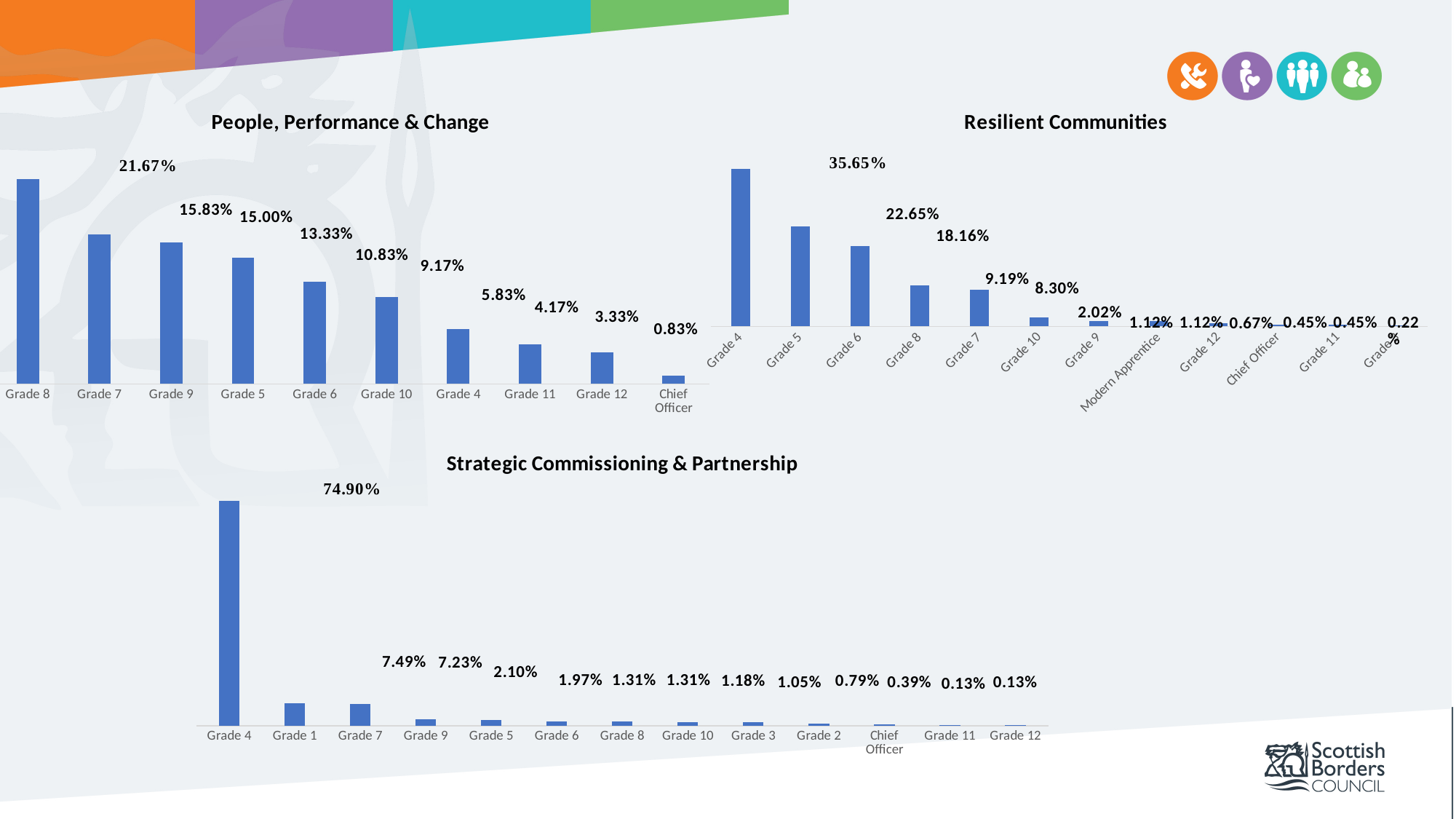
In the People, Performance & Change chart, what is the value for Grade 8? 21.67% In the Resilient Communities chart, which category has the highest value? Grade 4 In the Resilient Communities chart, what is the value for Grade 5? 22.65% In the Strategic Commissioning & Partnership chart, what is the difference between Grade 1 and Grade 7? 0.26% What type of chart is the Strategic Commissioning & Partnership chart? Bar chart How many categories are shown in the Strategic Commissioning & Partnership chart? 13 In the Resilient Communities chart, which is larger, Grade 8 or Grade 7? Grade 8 In the People, Performance & Change chart, what is the difference between Grade 7 and Grade 9? 0.83% In the People, Performance & Change chart, which category has the lowest value? Chief Officer How many categories are shown in the People, Performance & Change chart? 10 In the Strategic Commissioning & Partnership chart, what is the value for Grade 4? 74.90% In the Resilient Communities chart, what is the value for Modern Apprentice? 1.12%